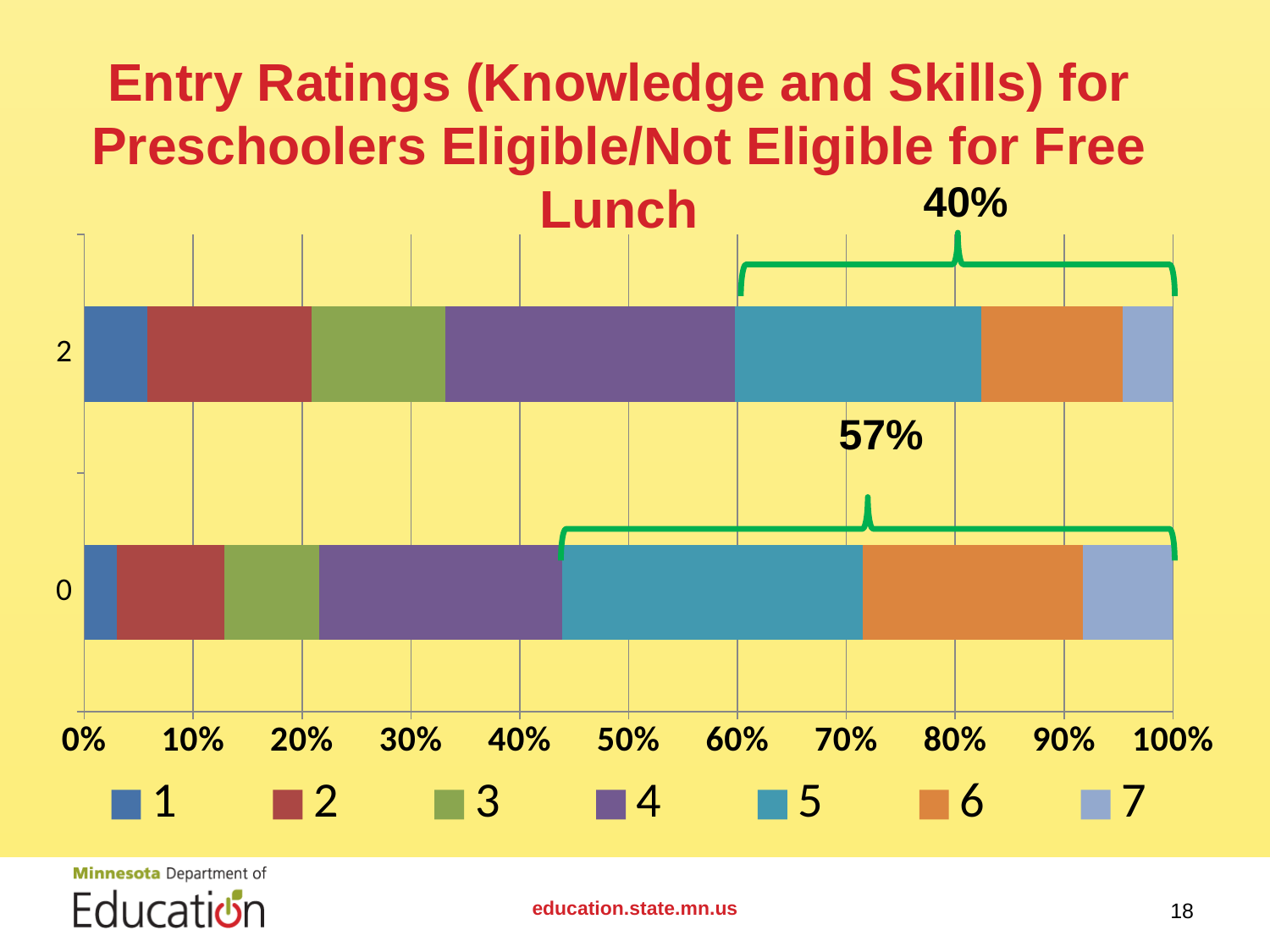
What is the difference between the bracketed percentages for category 0 and category 2? 17% Is the bracketed share for category 2 greater or less than 50%? less Which bar has the larger segment for series 6, category 2 or category 0? 0 How many series does the legend list? 7 What is the highest value shown on the horizontal axis? 100% Is the bracketed share for category 0 greater or less than 50%? greater How many categories (bars) does the chart show? 2 What is the title of the chart? Entry Ratings (Knowledge and Skills) for Preschoolers Eligible/Not Eligible for Free Lunch What percentage is annotated above the bracket on the bar for category 0? 57% What kind of chart is shown on the slide? Stacked bar chart Which category has the larger bracketed share, 2 or 0? 0 What percentage is annotated above the bracket on the bar for category 2? 40%